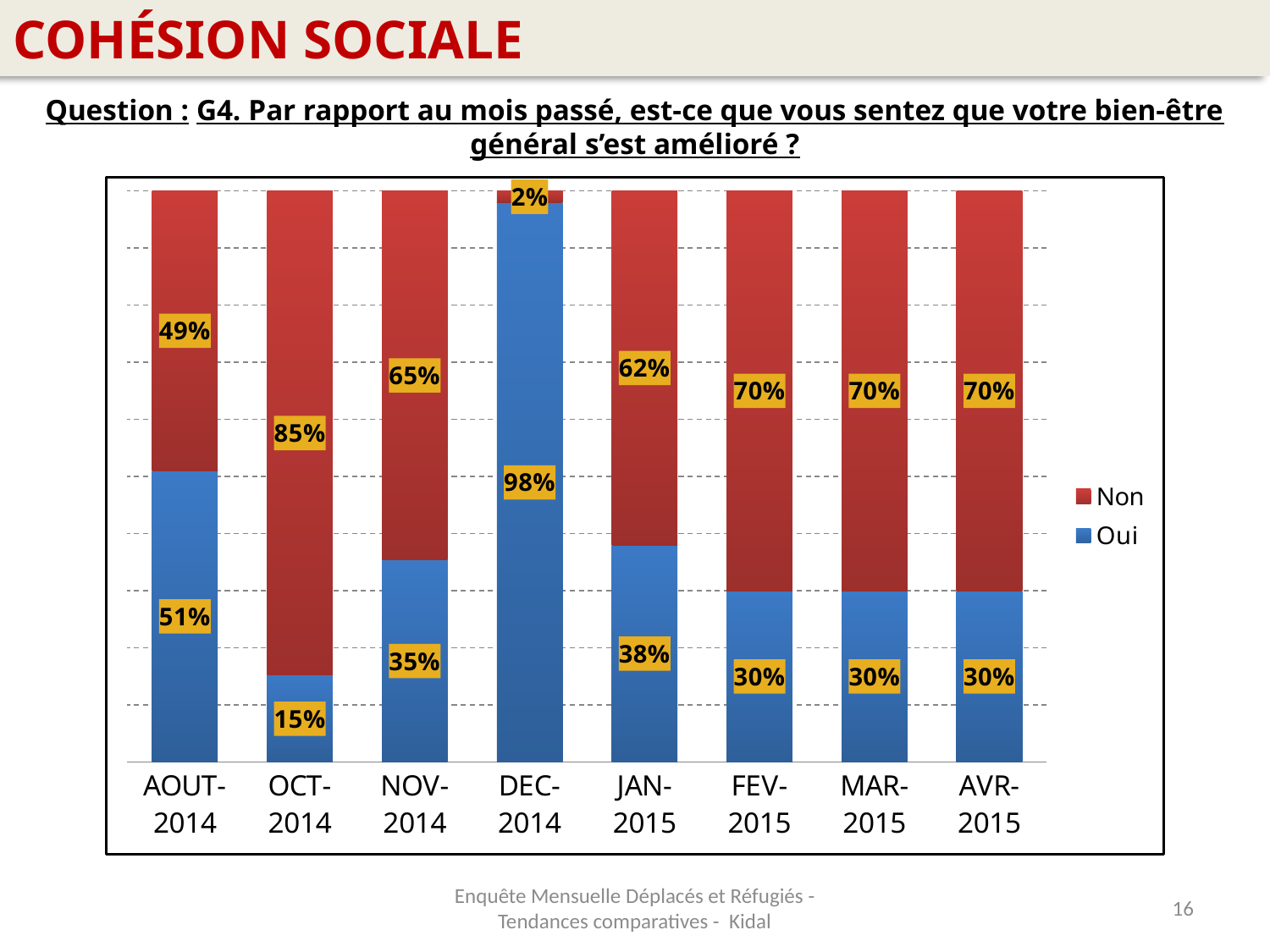
Which month has the lowest value for Oui? OCT-2014 How many series does the legend list? 2 Which colour represents the Non series in the chart? Red What is the difference between the Non values for OCT-2014 and NOV-2014? 20% Which is larger, the Oui value for JAN-2015 or the Oui value for FEV-2015? JAN-2015 What is the value for Non in OCT-2014? 85% How many months are shown on the x axis? 8 Which month has the highest value for Oui? DEC-2014 What is the value for Oui in DEC-2014? 98% What kind of chart is shown on the slide? Stacked bar chart What is the total of the stacked bar for MAR-2015? 100% What is the value for Oui in AOUT-2014? 51%